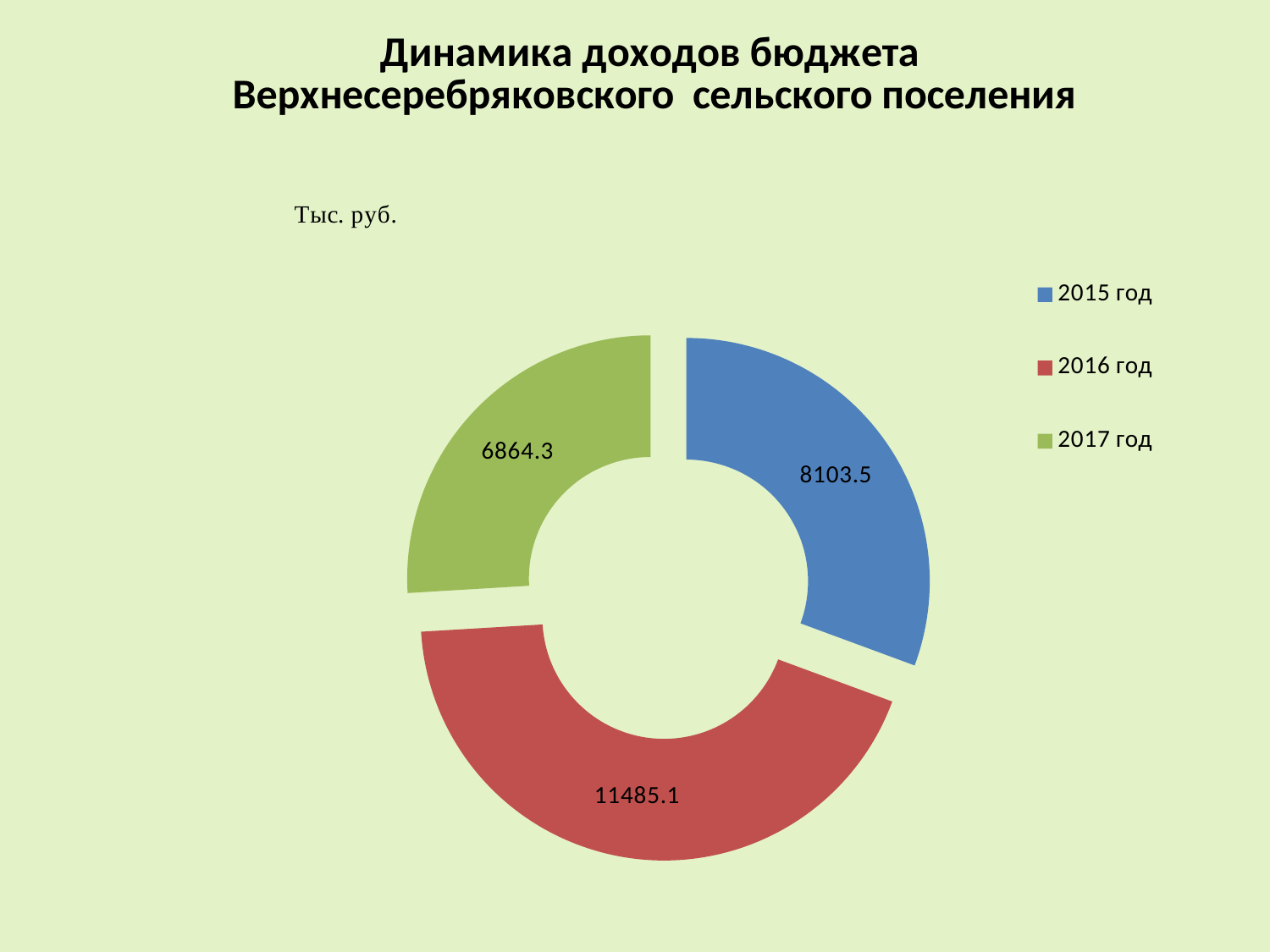
Which year has the lowest value? 2017 год What is the value for 2015 год? 8103.5 What is the difference between the values for 2015 год and 2017 год? 1239.2 Which is larger, the value for 2015 год or the value for 2017 год? 2015 год How many entries does the legend list? 3 Which year has the highest value? 2016 год What kind of chart is shown on the slide? doughnut chart What is the value for 2016 год? 11485.1 How many slices does the chart have? 3 What is the value for 2017 год? 6864.3 What unit of measurement is indicated on the slide? Тыс. руб. What is the difference between the values for 2016 год and 2015 год? 3381.6